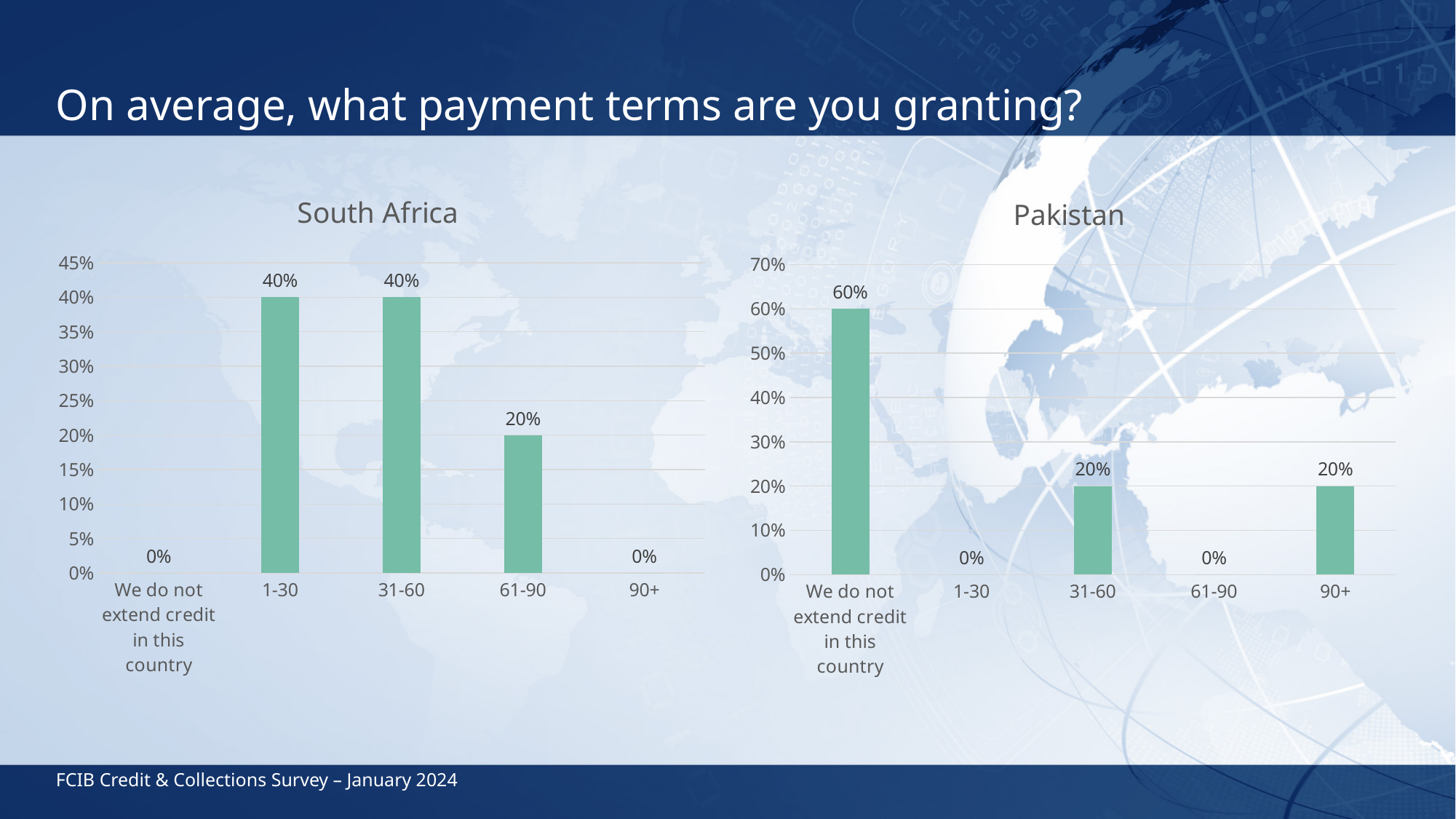
In the South Africa chart, what is the value for 61-90? 20% In the South Africa chart, what is the value for 1-30? 40% In the Pakistan chart, which category has the highest value? We do not extend credit in this country What kind of chart is the South Africa chart? Bar chart In the South Africa chart, what is the difference between the values for 31-60 and 61-90? 20% In the Pakistan chart, what is the difference between the values for 'We do not extend credit in this country' and 31-60? 40% In the Pakistan chart, what is the value for 90+? 20% What is the title of the chart on the right side of the slide? Pakistan In the South Africa chart, what is the value for 90+? 0% In the South Africa chart, which is larger, the value for 1-30 or the value for 61-90? 1-30 How many categories are shown on the x axis of the Pakistan chart? 5 In the Pakistan chart, what is the value for 'We do not extend credit in this country'? 60%